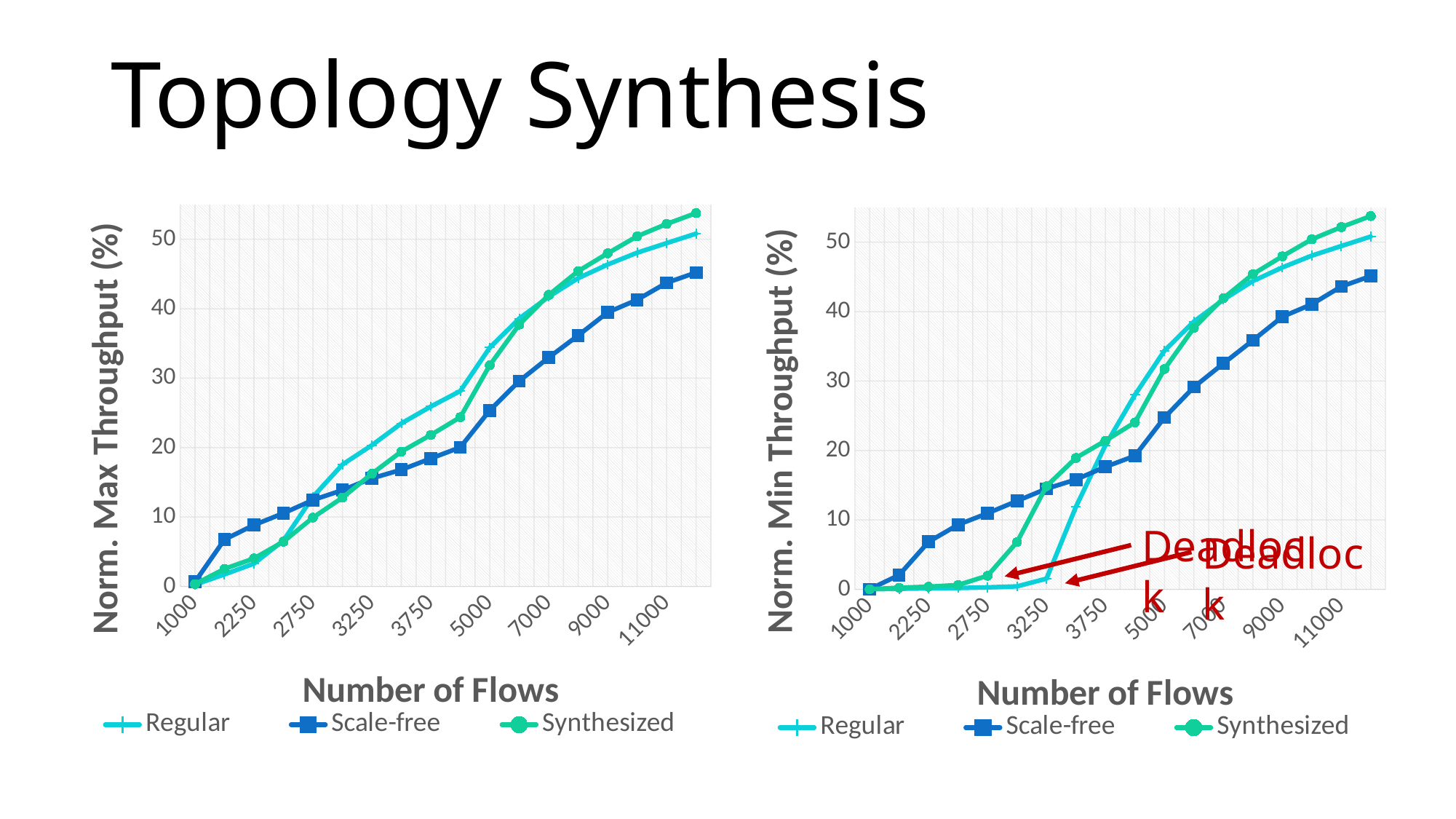
What is the x-axis title of the right chart? Number of Flows In the left chart (Norm. Max Throughput), do the Synthesized values rise or fall as the number of flows increases? rise In the left chart (Norm. Max Throughput), at 11000 flows, which is larger: Synthesized or Scale-free? Synthesized How many labelled tick values are shown on the x axis of the left chart? 9 In the left chart (Norm. Max Throughput), which series has the highest value at 11000 flows? Synthesized In the right chart (Norm. Min Throughput), which series has the lowest value at the rightmost point? Scale-free How many series does the legend of the right chart (Norm. Min Throughput) list? 3 In the left chart (Norm. Max Throughput), is the Scale-free value at 11000 flows greater or less than 40? greater In the right chart (Norm. Min Throughput), is the Regular value at 2750 flows greater or less than 10? less What kind of chart is the left chart, titled Norm. Max Throughput (%)? line chart In the right chart (Norm. Min Throughput), at 3250 flows, which is larger: Scale-free or Regular? Scale-free